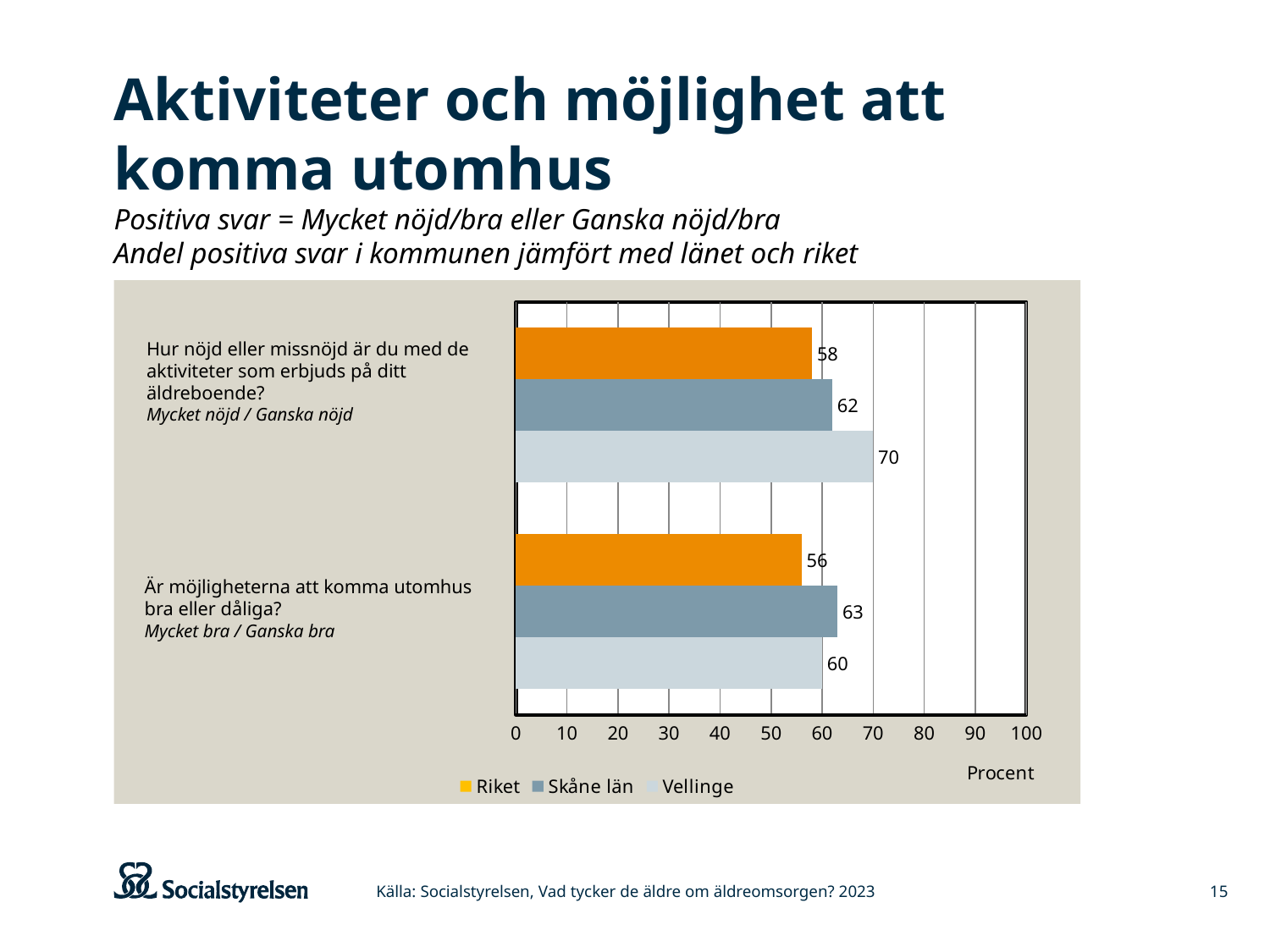
What is the difference between Vellinge and Riket on the question about satisfaction with activities offered? 12 Is the value for Vellinge on the question about satisfaction with activities offered greater or less than 60? greater What kind of chart is shown on the slide? Bar chart What is the value for Riket on the question about opportunities to get outdoors ("Är möjligheterna att komma utomhus bra eller dåliga?")? 56 What is the value for Skåne län on the question about opportunities to get outdoors? 63 What is the value for Vellinge on the question about satisfaction with activities offered at the care home ("Hur nöjd eller missnöjd är du med de aktiviteter som erbjuds på ditt äldreboende?")? 70 How many series does the legend list? 3 How many survey questions (categories) are shown in the chart? 2 Which series has the lowest value on the question about opportunities to get outdoors? Riket Which is larger on the question about opportunities to get outdoors: Skåne län or Vellinge? Skåne län Which series has the highest value on the question about satisfaction with activities offered? Vellinge What unit is shown on the horizontal axis of the chart? Procent